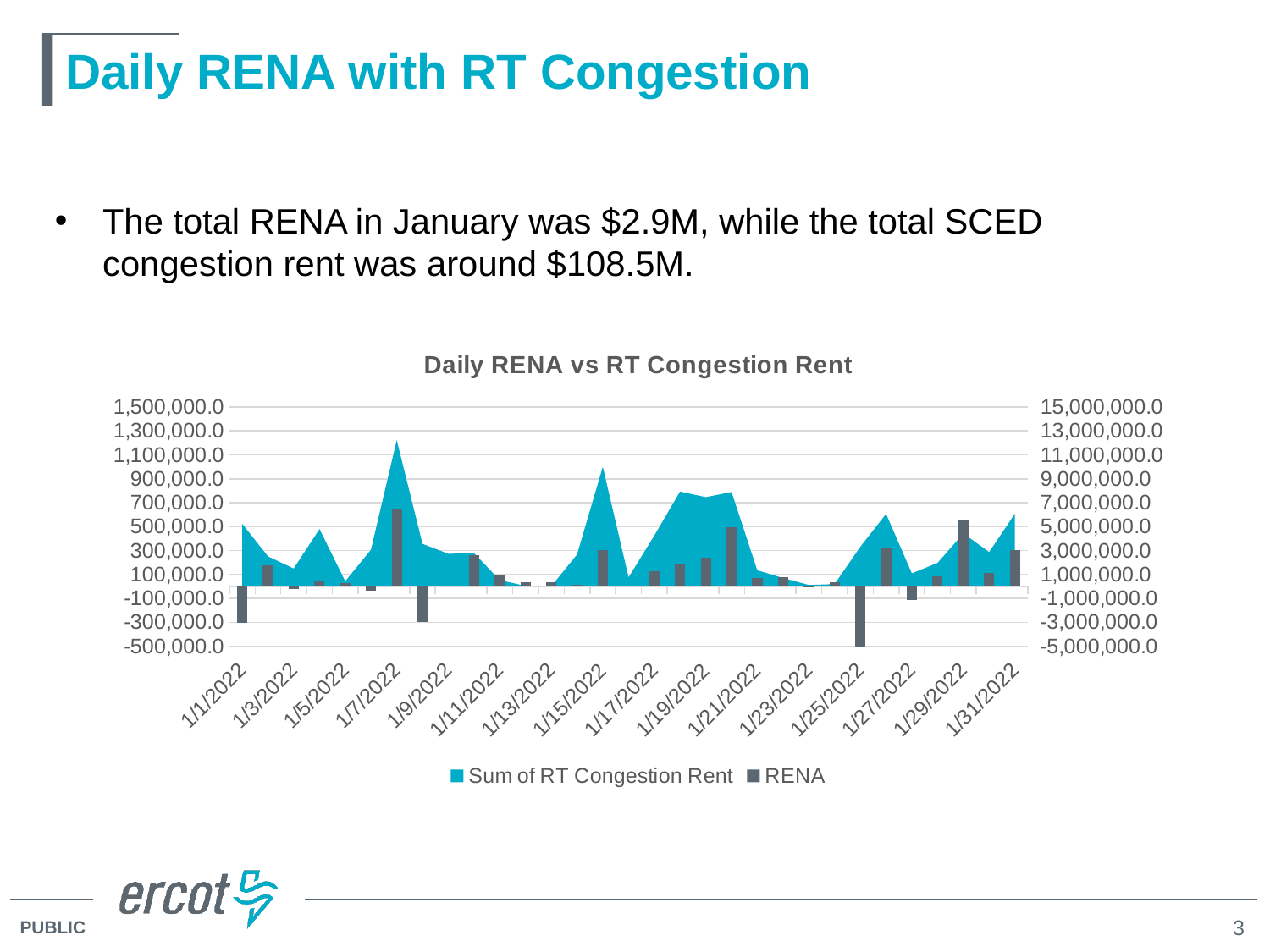
On which date is the RENA bar the lowest (most negative)? 1/25/2022 How many date labels are shown on the x axis of the chart? 16 How many series does the chart legend list? 2 What kind of chart is used to show the data? A combination chart with an area series and a bar series On which date does the RENA bar reach its highest positive value? 1/7/2022 Which date has the larger Sum of RT Congestion Rent, 1/15/2022 or 1/23/2022? 1/15/2022 Is the RENA value for 1/1/2022 positive or negative? negative What is the title of the chart? Daily RENA vs RT Congestion Rent On which date does the Sum of RT Congestion Rent area reach its highest peak? 1/7/2022 What are the two series named in the chart legend? Sum of RT Congestion Rent and RENA Which date has the larger RENA bar, 1/7/2022 or 1/3/2022? 1/7/2022 Is the RENA value for 1/25/2022 positive or negative? negative